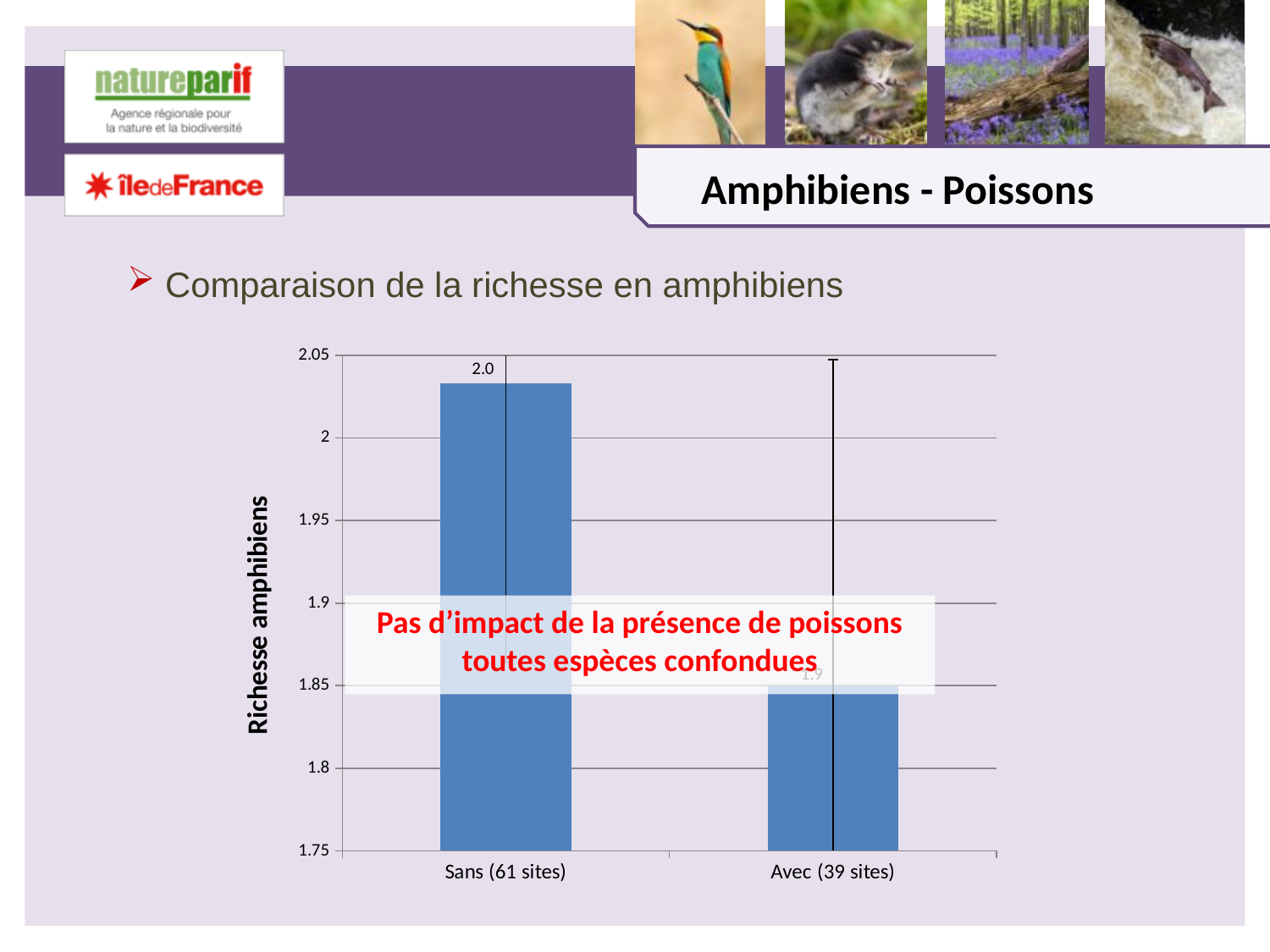
What is the title of the y axis of the chart? Richesse amphibiens What is the value for Sans (61 sites)? 2.0 Which is larger, the value for Sans (61 sites) or the value for Avec (39 sites)? Sans (61 sites) Which category has the lowest value? Avec (39 sites) Which category has the highest value? Sans (61 sites) What kind of chart is shown on the slide? bar chart How many categories are plotted on the x axis of the chart? 2 How many sites are indicated in the label of the Avec category? 39 Is the value for Avec (39 sites) greater or less than 2? less Do the values rise or fall from left to right along the x axis? fall